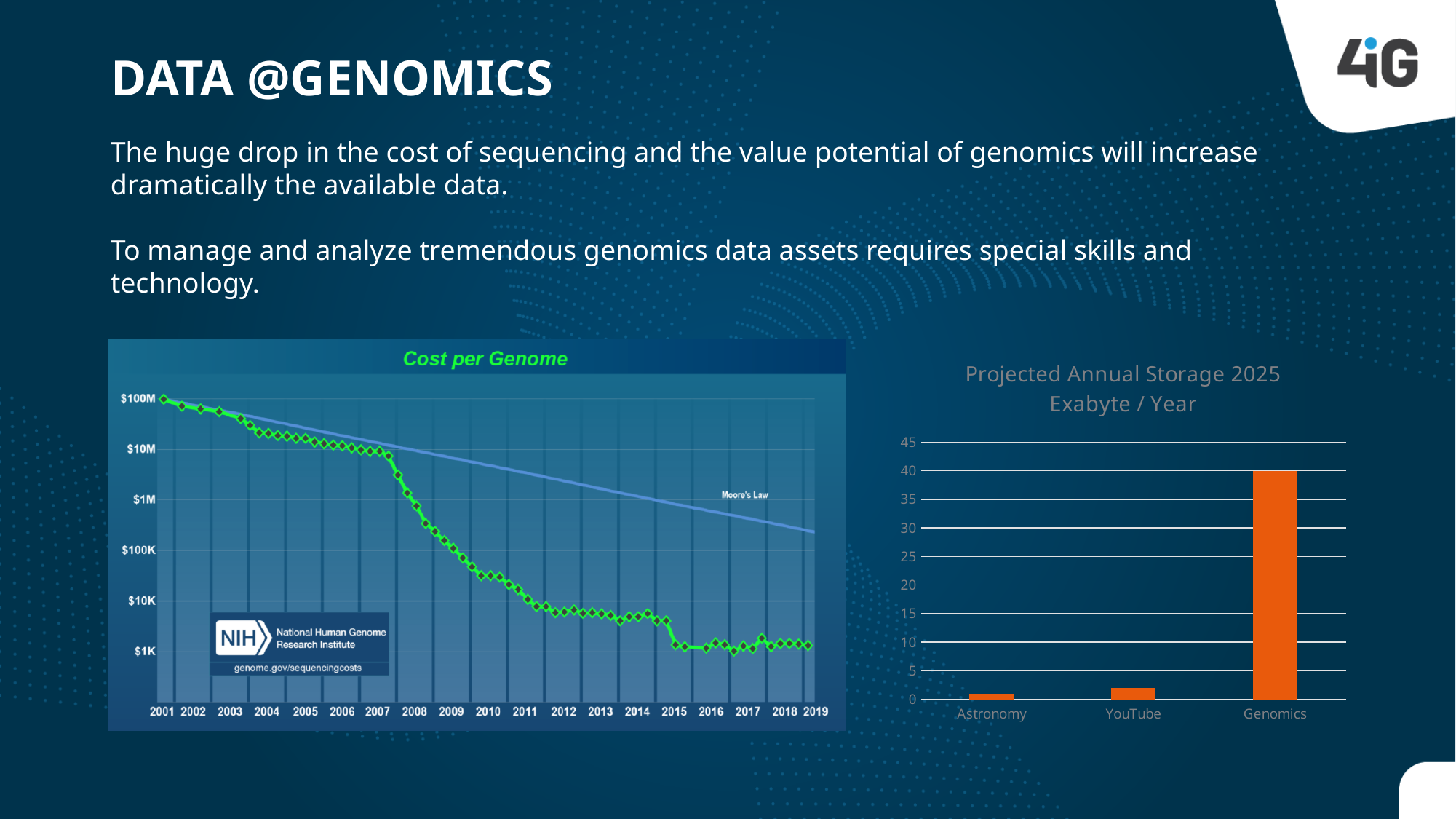
In the 'Cost per Genome' chart, do the values rise or fall from 2001 to 2019? fall In the 'Projected Annual Storage 2025 Exabyte / Year' chart, which is larger, the value for YouTube or the value for Genomics? Genomics What kind of chart is the 'Cost per Genome' chart? line chart In the 'Projected Annual Storage 2025 Exabyte / Year' chart, how many categories are shown on the x axis? 3 In the 'Cost per Genome' chart, is the value for 2019 greater or less than $10K? less What kind of chart is the 'Projected Annual Storage 2025 Exabyte / Year' chart? bar chart In the 'Projected Annual Storage 2025 Exabyte / Year' chart, which category has the lowest value? Astronomy In the 'Projected Annual Storage 2025 Exabyte / Year' chart, what is the value for Genomics? 40 In the 'Cost per Genome' chart, what is the label on the straight blue reference line? Moore's Law In the 'Projected Annual Storage 2025 Exabyte / Year' chart, which category has the highest value? Genomics In the 'Cost per Genome' chart, is the value for 2010 greater or less than $10K? greater In the 'Projected Annual Storage 2025 Exabyte / Year' chart, is the value for YouTube greater or less than 5? less